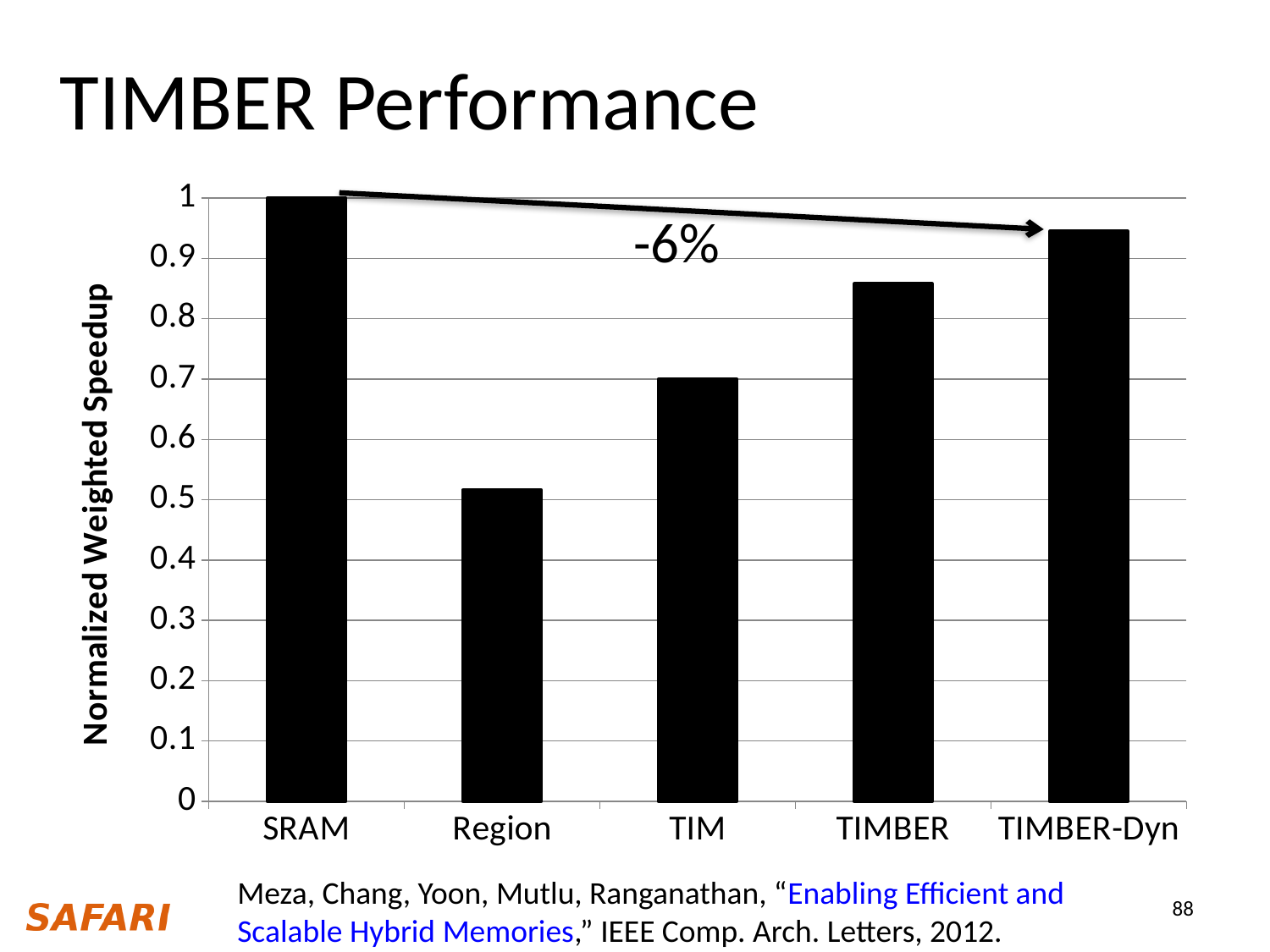
Which category has the highest normalized weighted speedup? SRAM What is the label on the y axis? Normalized Weighted Speedup Is the value for TIM greater or less than 0.6? greater Which category has the lowest normalized weighted speedup? Region Is the value for Region greater or less than 0.6? less How many categories are plotted on the x axis? 5 Is the value for TIMBER-Dyn greater or less than 0.9? greater Which has a higher normalized weighted speedup, Region or TIM? TIM Which has a higher normalized weighted speedup, TIMBER or TIMBER-Dyn? TIMBER-Dyn What is the normalized weighted speedup for SRAM? 1 What kind of chart is shown on the slide? bar chart